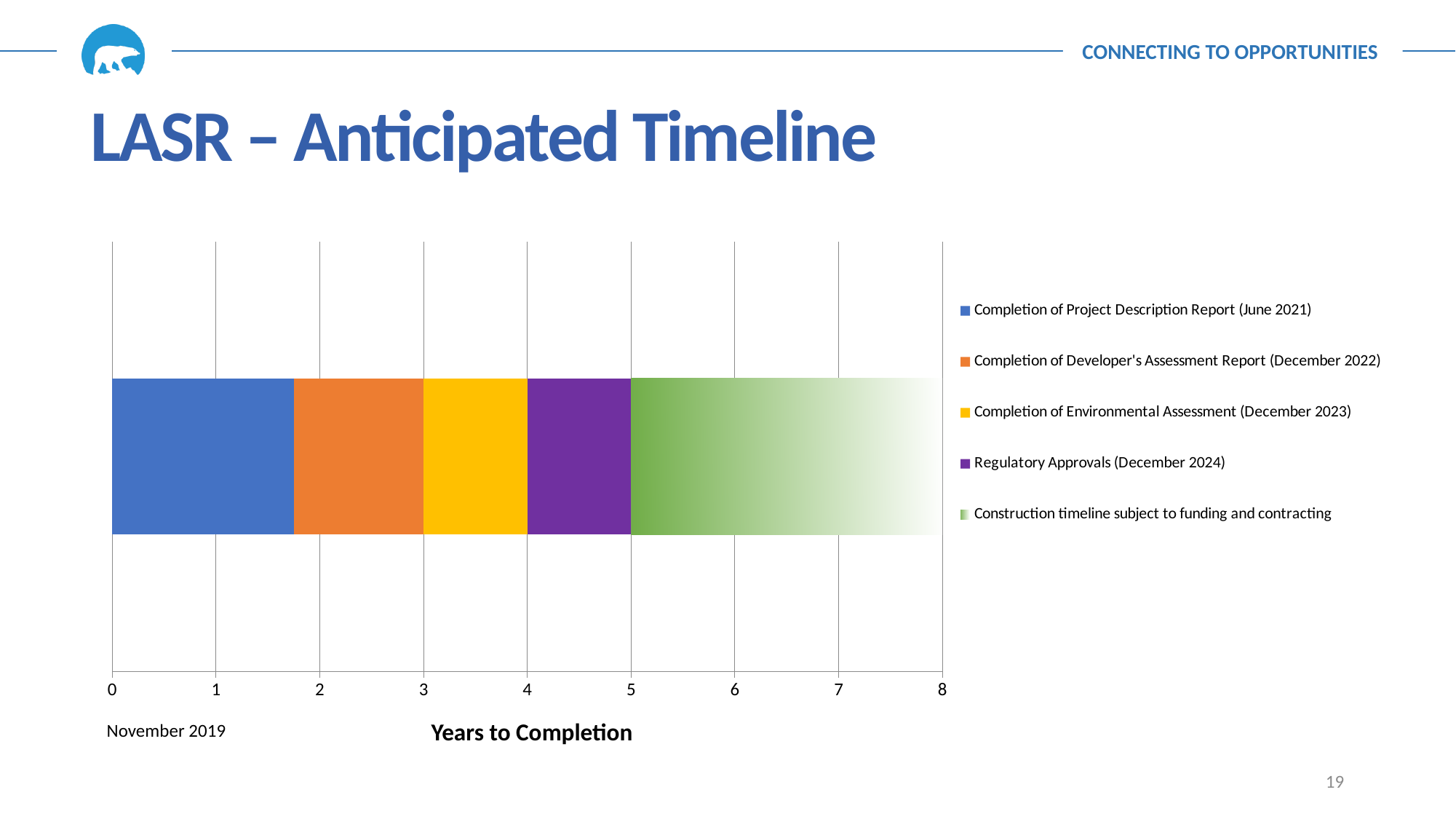
Which segment is longer: Completion of Project Description Report (June 2021) or Completion of Developer's Assessment Report (December 2022)? Completion of Project Description Report (June 2021) Is the length of the Construction timeline subject to funding and contracting segment greater or less than 2 years? greater What is the highest value shown on the x axis? 8 What is the title of the horizontal axis? Years to Completion Is the length of the Completion of Project Description Report (June 2021) segment greater or less than 1 year? greater How many series does the legend list? 5 What kind of chart is shown on the slide? bar chart Which colour represents Regulatory Approvals (December 2024) in the chart? purple Which series has the longest segment in the stacked bar? Construction timeline subject to funding and contracting Which segment is longer: Completion of Environmental Assessment (December 2023) or Construction timeline subject to funding and contracting? Construction timeline subject to funding and contracting Is the length of the Completion of Project Description Report (June 2021) segment greater or less than 2 years? less